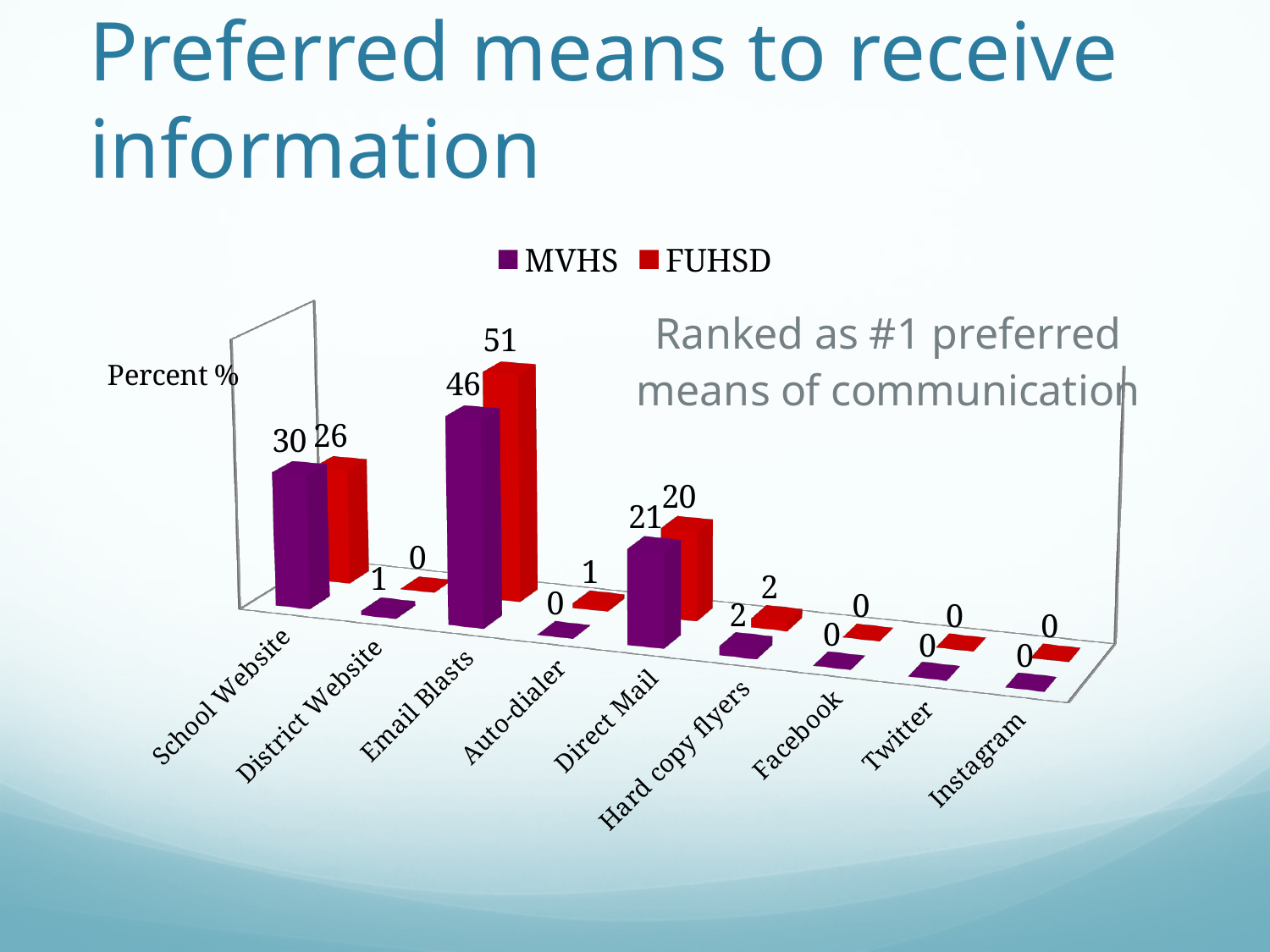
Which colour represents the FUHSD series? Red Which category has the highest FUHSD value? Email Blasts What kind of chart is shown on the slide? Bar chart What is the FUHSD value for Auto-dialer? 1 What is the MVHS value for Email Blasts? 46 How many series does the legend list? 2 What is the FUHSD value for School Website? 26 What is the difference between the MVHS values for School Website and Direct Mail? 9 Which is larger for School Website, the MVHS value or the FUHSD value? MVHS How many categories are shown on the x axis? 9 What is the MVHS value for Direct Mail? 21 What is the difference between the FUHSD and MVHS values for Email Blasts? 5